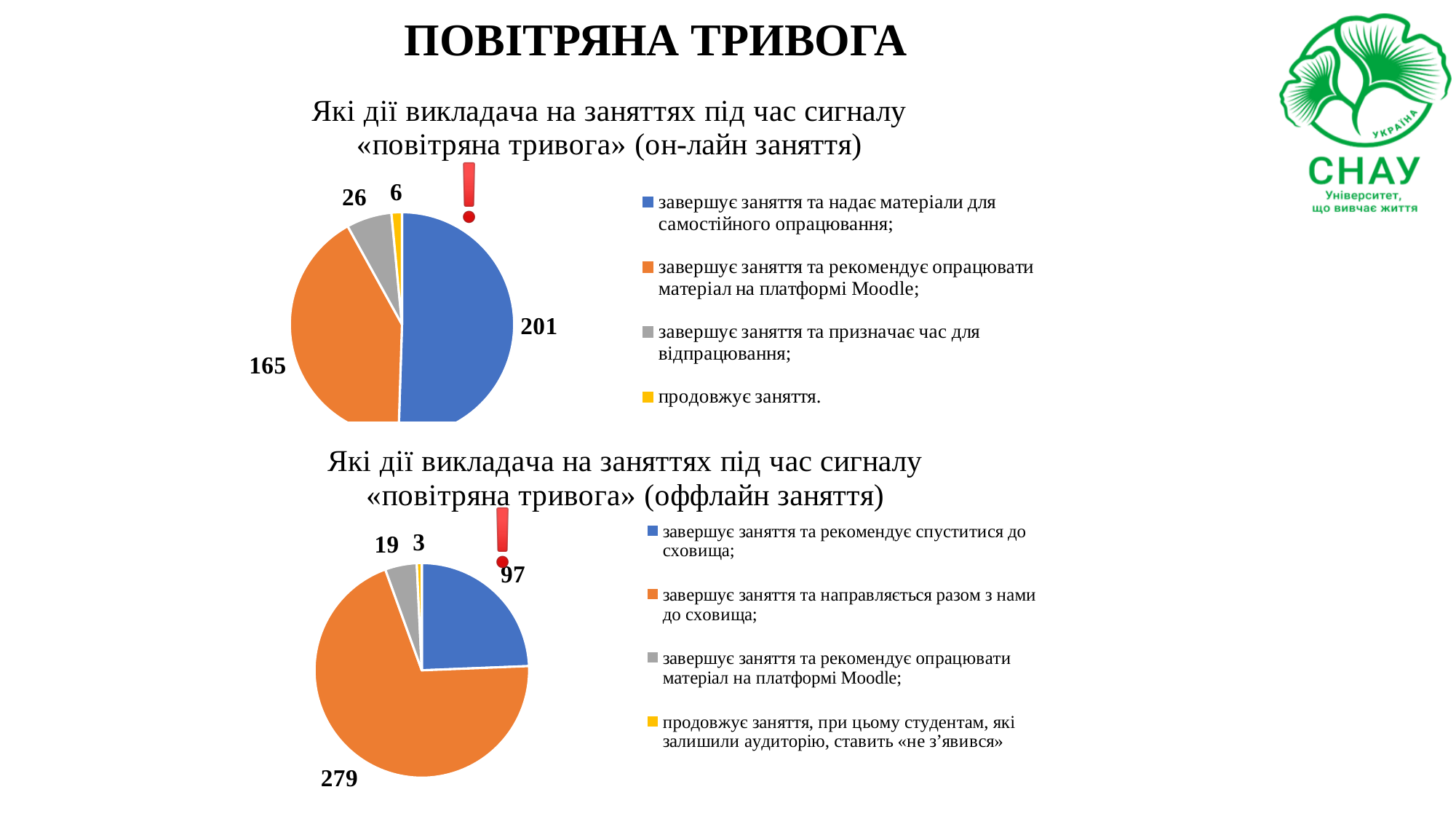
On the top chart (on-line classes), which category has the largest slice? завершує заняття та надає матеріали для самостійного опрацювання On the top chart (on-line classes), what value is shown for the slice 'завершує заняття та надає матеріали для самостійного опрацювання'? 201 On the bottom chart (offline classes), which is larger: the blue slice or the orange slice? the orange slice On the top chart (on-line classes), what value is shown for the slice 'продовжує заняття'? 6 On the bottom chart (offline classes), what is the difference between the values 279 and 97? 182 On the bottom chart (offline classes), what value is shown for the slice 'завершує заняття та рекомендує опрацювати матеріал на платформі Moodle'? 19 On the bottom chart (offline classes), what is the total of all four slices? 398 On the top chart (on-line classes), what is the difference between the values 201 and 165? 36 What type of chart is used for the offline classes data at the bottom of the slide? pie chart On the bottom chart (offline classes), which category has the smallest slice? продовжує заняття, при цьому студентам, які залишили аудиторію, ставить «не з'явився» How many slices does the top chart (on-line classes) have? 4 On the bottom chart (offline classes), what value is shown for the slice 'завершує заняття та направляється разом з нами до сховища'? 279